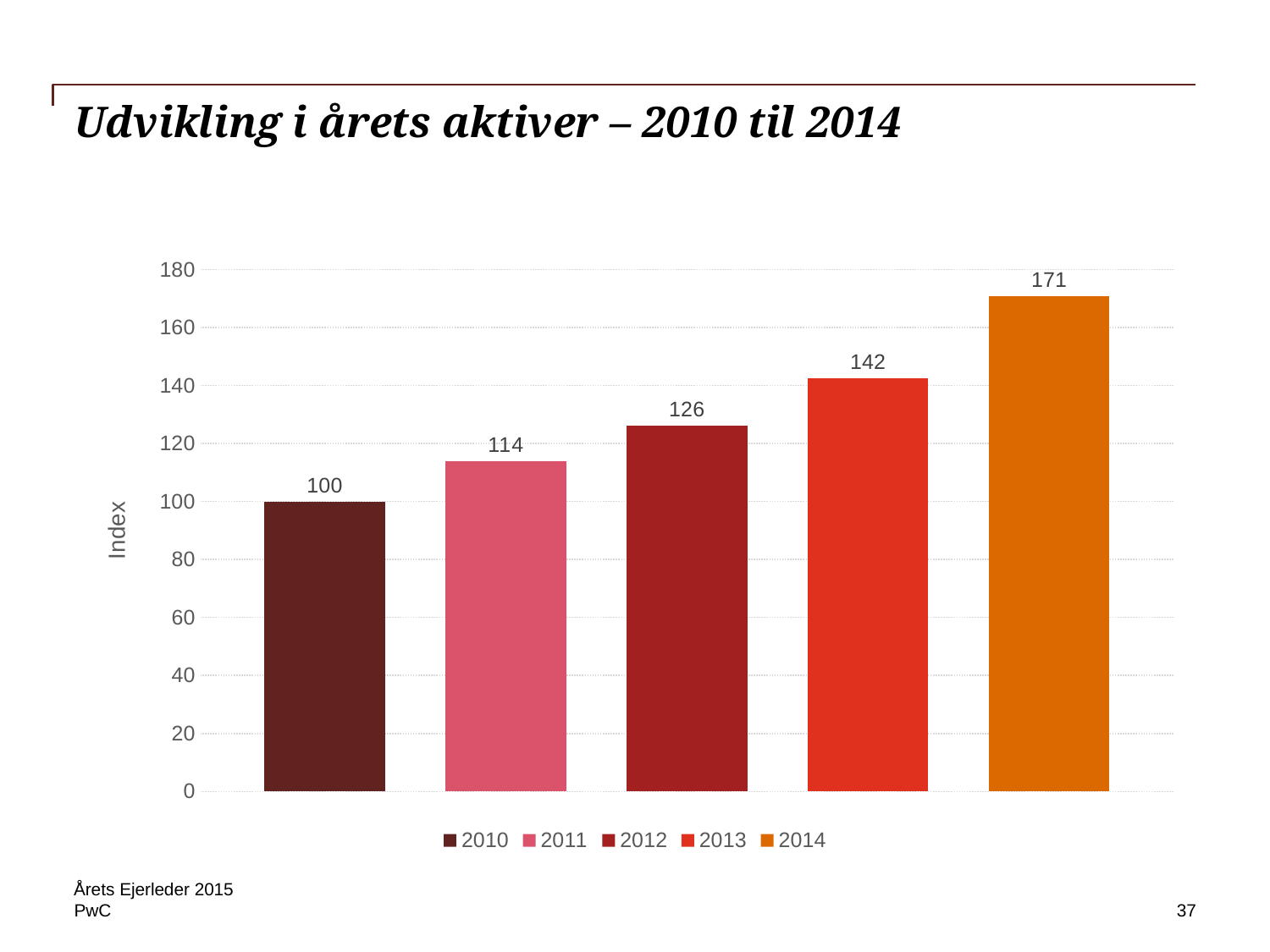
What is the index value for 2014? 171 What is the difference between the index values for 2013 and 2012? 16 What is the index value for 2010? 100 What kind of chart is shown on the slide? bar chart What is the index value for 2012? 126 Which is larger, the index value for 2011 or for 2013? 2013 Which year has the highest index value? 2014 Which year has the lowest index value? 2010 What is the difference between the index values for 2014 and 2010? 71 Do the index values rise or fall from 2010 to 2014? rise How many bars are shown in the chart? 5 Is the index value for 2013 greater or less than 140? greater